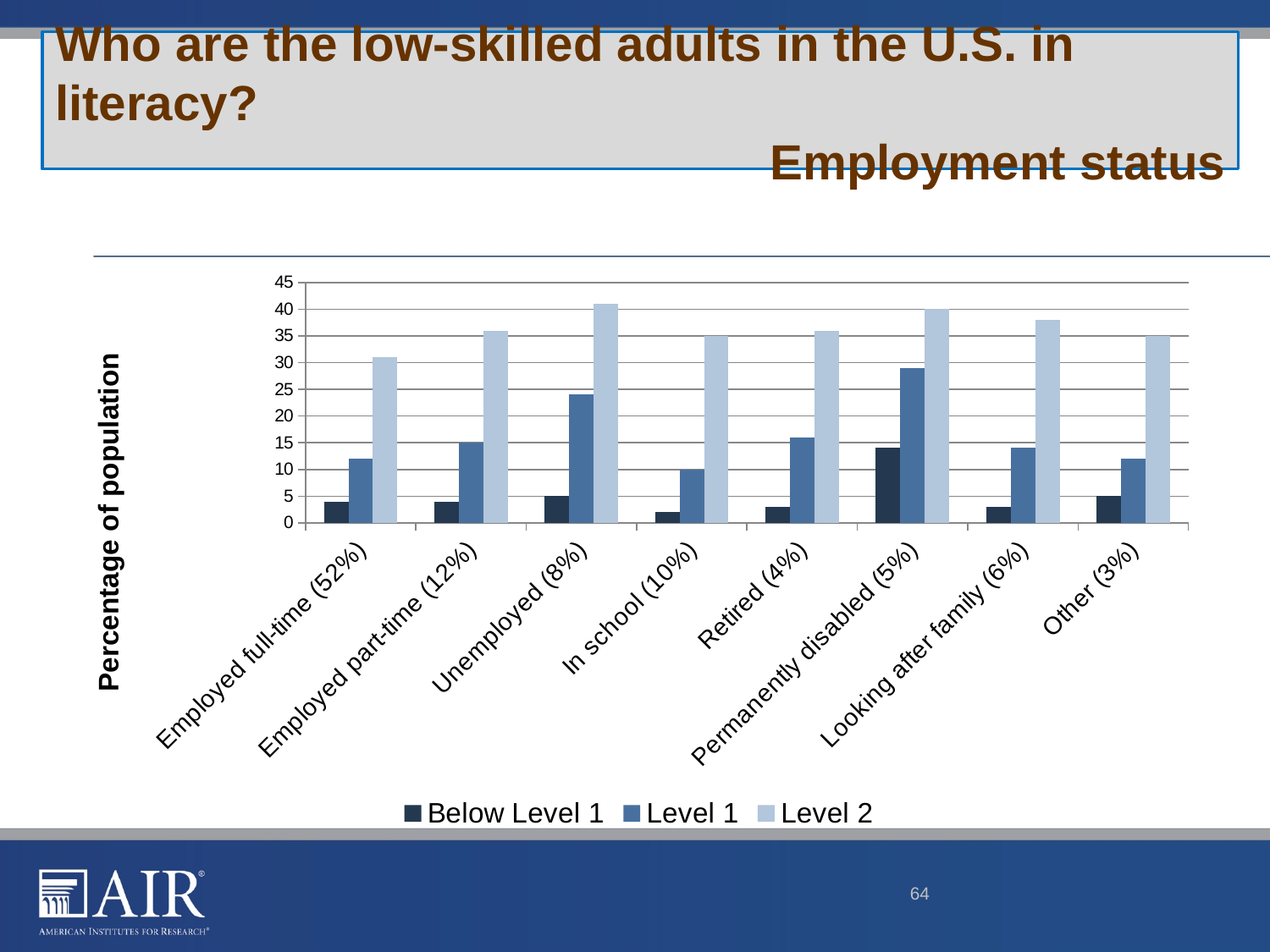
What is the label on the vertical axis of the chart? Percentage of population What are the three series listed in the legend? Below Level 1, Level 1, Level 2 Is the Level 2 value for Employed full-time (52%) greater or less than 35? less How many employment status categories are shown on the x axis? 8 How many series does the legend list? 3 What kind of chart is shown on the slide? bar chart Is the Level 1 value for Permanently disabled (5%) greater or less than 25? greater Which employment status category has the highest Below Level 1 value? Permanently disabled (5%) Which is larger, the Level 1 value for Unemployed (8%) or the Level 1 value for Retired (4%)? Unemployed (8%) Is the Below Level 1 value for Permanently disabled (5%) greater or less than 10? greater Which employment status category has the lowest Level 2 value? Employed full-time (52%) Which is larger, the Below Level 1 value for Permanently disabled (5%) or the Below Level 1 value for In school (10%)? Permanently disabled (5%)